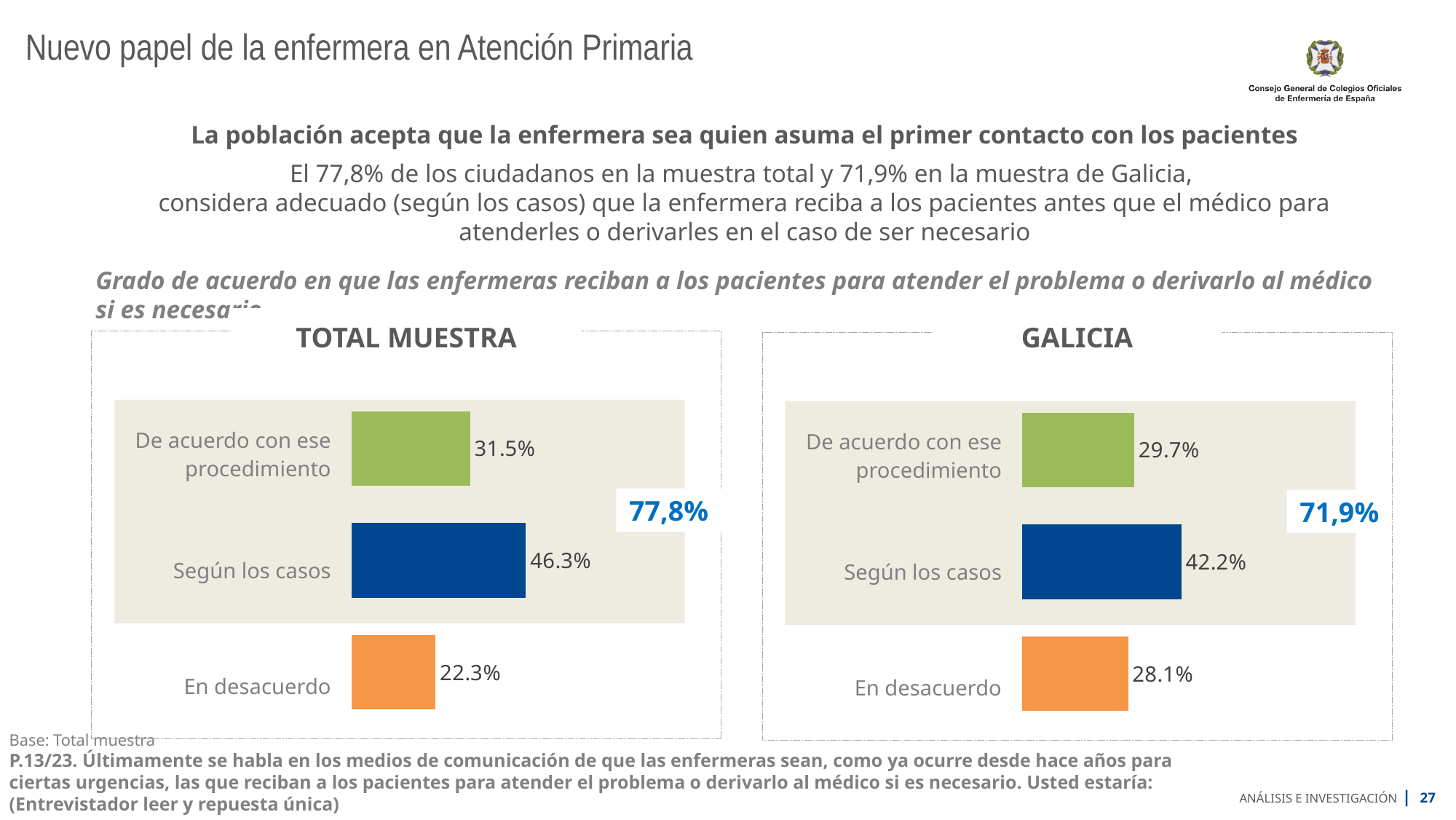
In the GALICIA chart, what is the value for "De acuerdo con ese procedimiento"? 29.7% In the GALICIA chart, what is the difference between "Según los casos" and "En desacuerdo"? 14.1% How many categories does the TOTAL MUESTRA chart show? 3 In the TOTAL MUESTRA chart, which category has the highest value? Según los casos In the TOTAL MUESTRA chart, what combined percentage is highlighted for the first two categories? 77,8% In the TOTAL MUESTRA chart, what is the difference between "Según los casos" and "De acuerdo con ese procedimiento"? 14.8% In the TOTAL MUESTRA chart, what is the value for "Según los casos"? 46.3% In the GALICIA chart, which category has the lowest value? En desacuerdo In the GALICIA chart, what colour is the bar for "Según los casos"? Dark blue Which is larger: "En desacuerdo" in the TOTAL MUESTRA chart or "En desacuerdo" in the GALICIA chart? GALICIA What kind of chart is the GALICIA chart? Bar chart In the GALICIA chart, what is the value for "En desacuerdo"? 28.1%